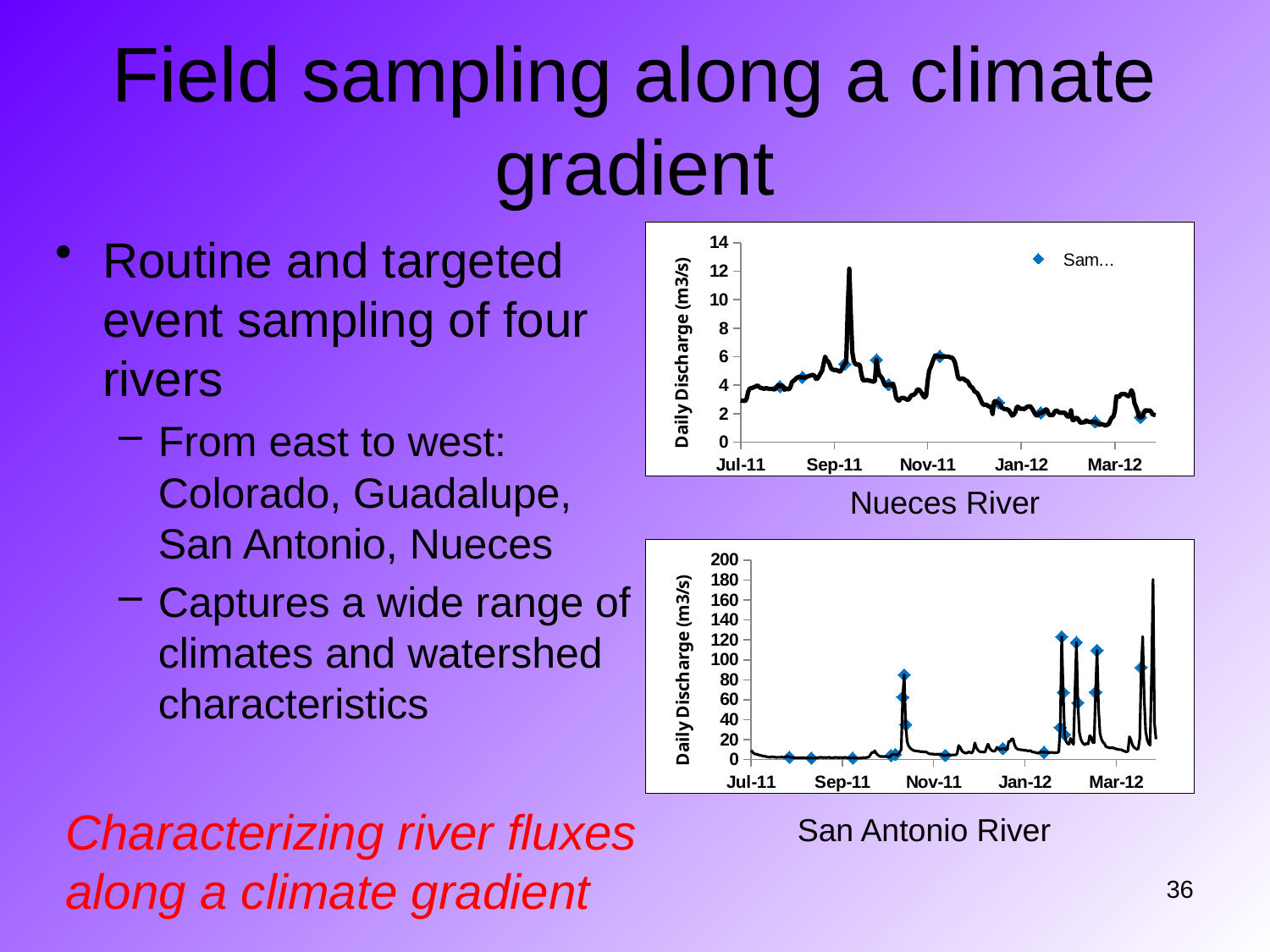
How many month labels are shown on the x-axis of the Nueces River chart? 5 In the Nueces River chart, is the peak discharge near Sep-11 greater or less than 10? greater In the San Antonio River chart, is the highest peak near Mar-12 greater or less than 160? greater In the Nueces River chart, is the discharge at Jan-12 greater or less than 4? less What is the y-axis label on the San Antonio River chart? Daily Discharge (m3/s) What is the highest value shown on the y-axis of the San Antonio River chart? 200 What kind of chart is the Nueces River chart? line chart In the Nueces River chart, does the discharge generally rise or fall from Nov-11 to Mar-12? fall What kind of chart is the San Antonio River chart? line chart